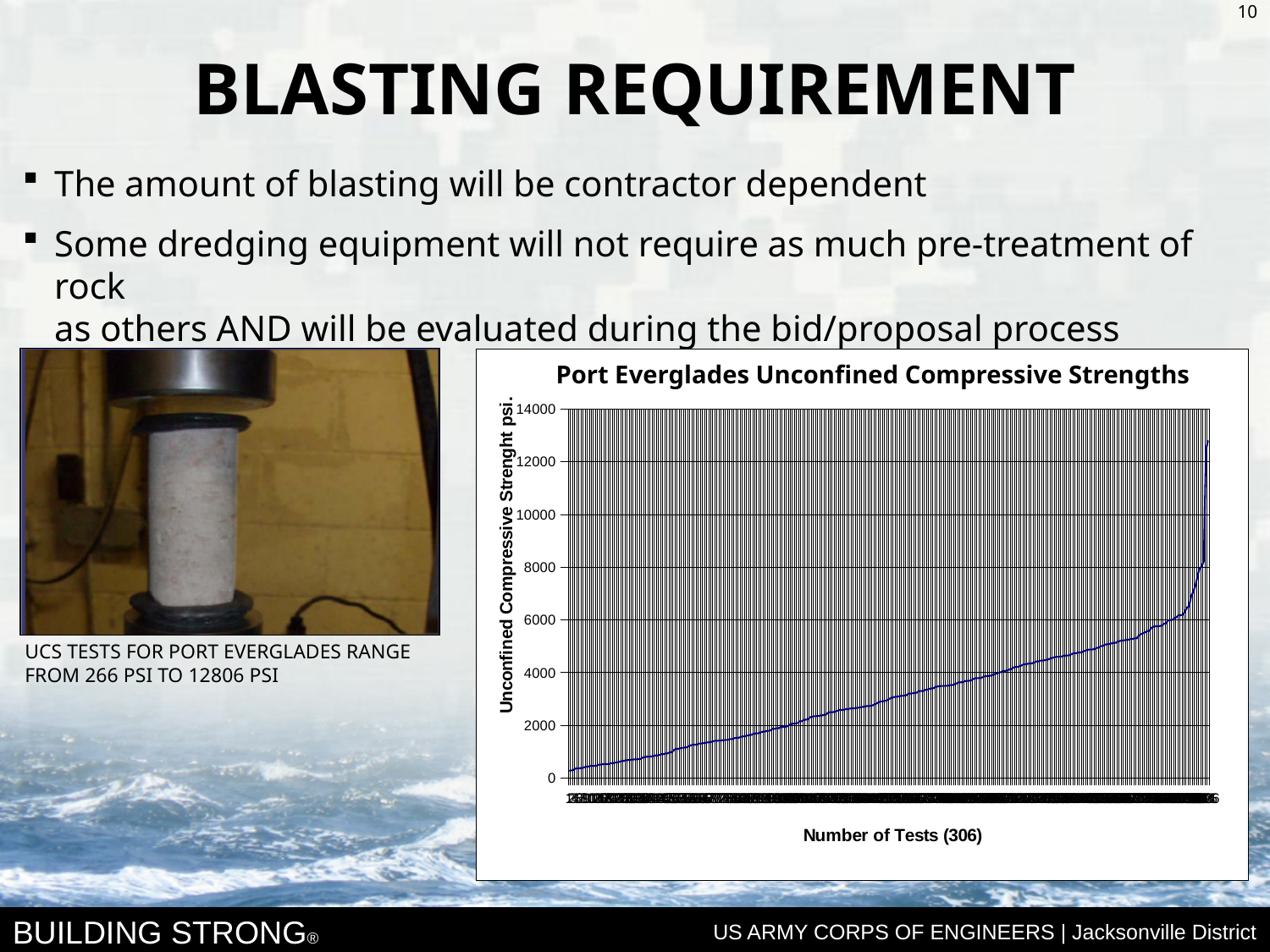
What kind of chart is shown on the slide? line chart How many lines (data series) are plotted in the chart? 1 What is the title of the chart? Port Everglades Unconfined Compressive Strengths According to the x-axis label, how many tests are plotted in the chart? 306 Is the lowest plotted value in the chart greater or less than 2000? less Is the highest plotted value in the chart greater or less than 12000? greater Do the plotted values rise or fall from left to right along the x axis? rise Is the highest plotted value in the chart greater or less than 14000? less What is the label on the vertical axis of the chart? Unconfined Compressive Strenght psi.